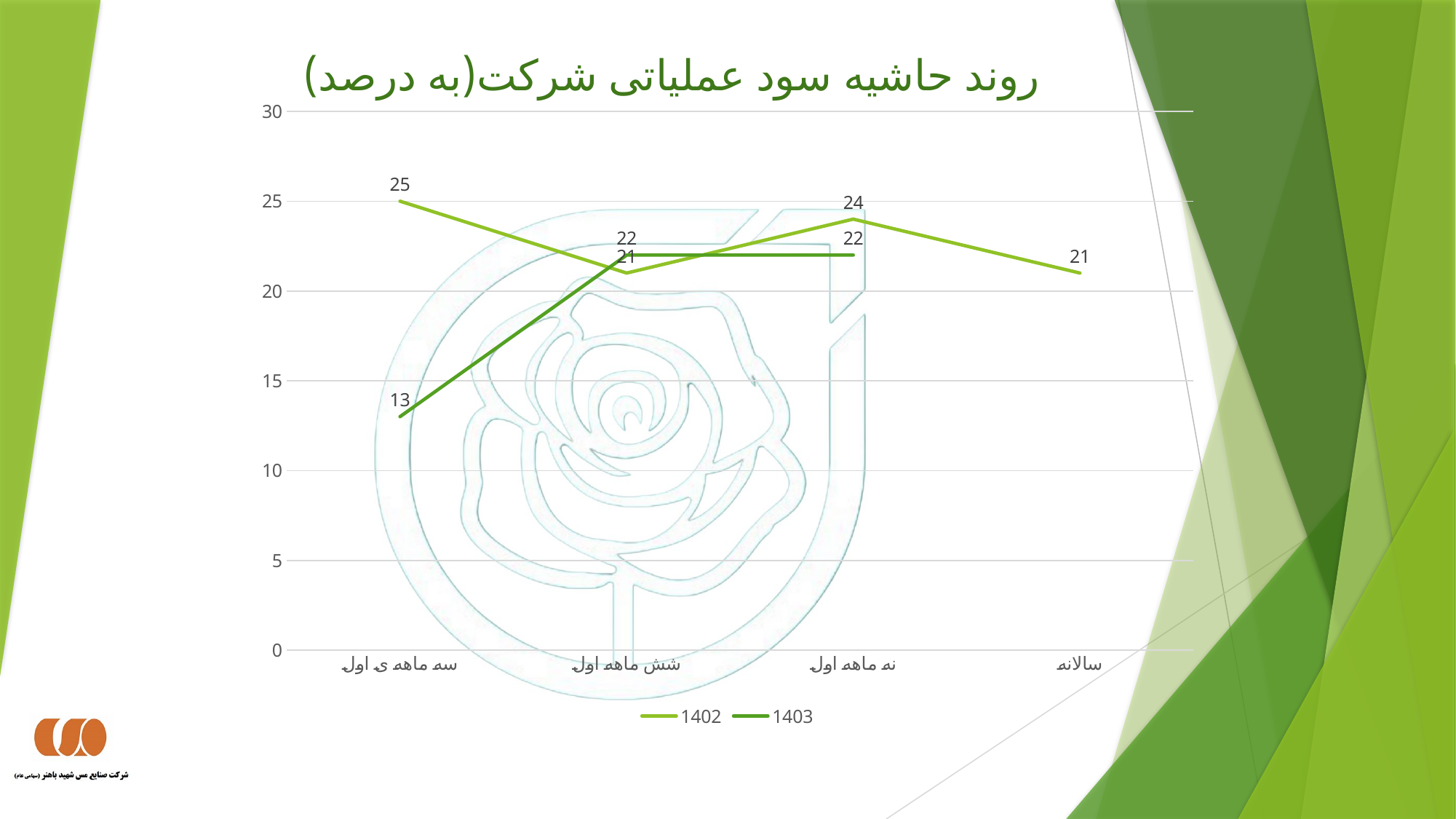
What type of chart is shown on the slide? line chart In which category is the 1403 series lowest? سه ماهه ی اول What is the value for 1403 in شش ماهه اول? 22 What is the value for 1402 in سالانه? 21 Which series has the larger value in نه ماهه اول, 1402 or 1403? 1402 What is the value for 1402 in سه ماهه ی اول? 25 What is the difference between the 1402 and 1403 values in سه ماهه ی اول? 12 What is the value for 1402 in نه ماهه اول? 24 How many categories are shown on the x axis? 4 In which category is the 1402 series highest? سه ماهه ی اول How many series does the legend list? 2 What is the value for 1403 in سه ماهه ی اول? 13